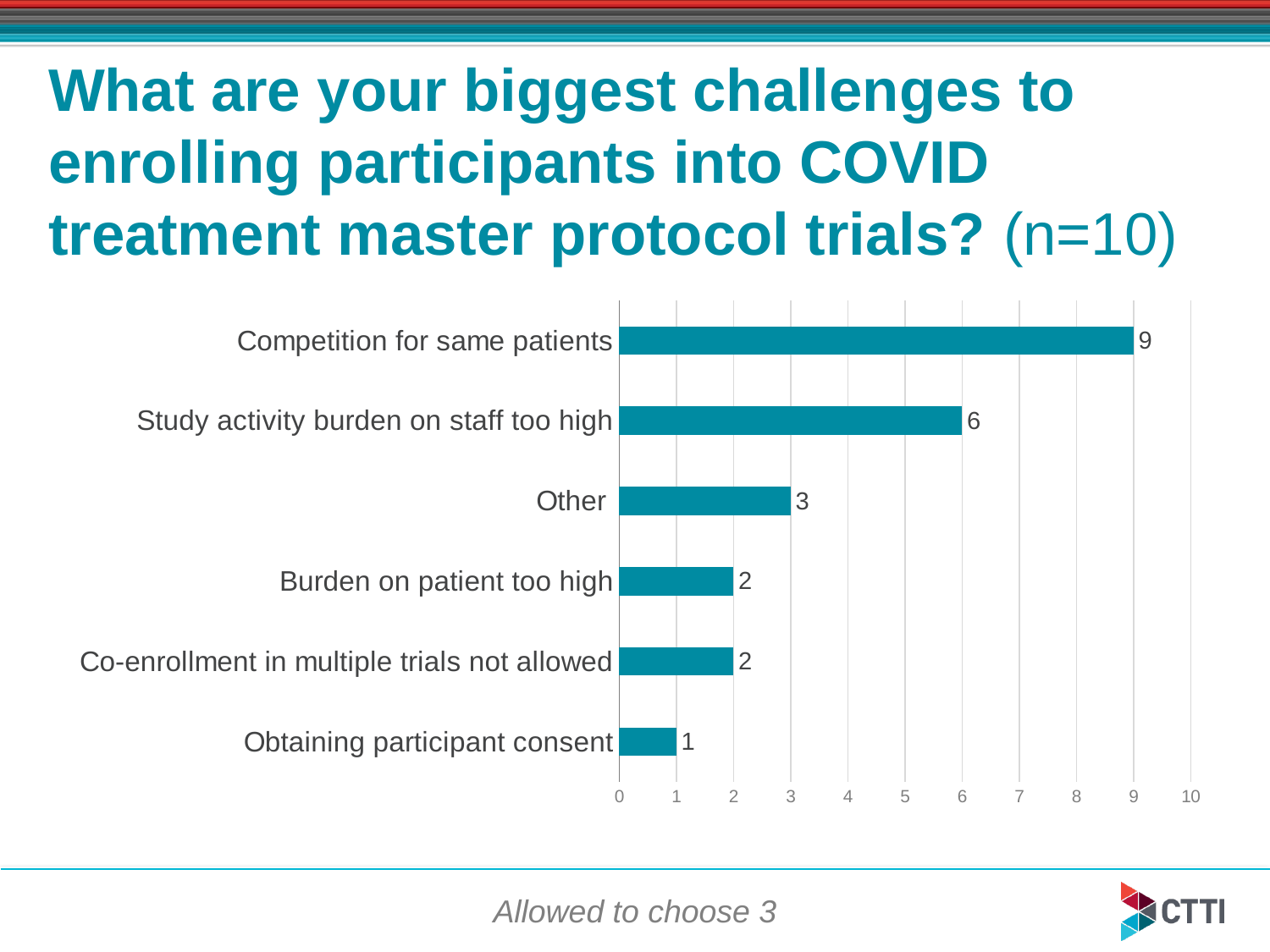
Which category has the lowest value? Obtaining participant consent What is the value for "Study activity burden on staff too high"? 6 What is the maximum value shown on the horizontal axis? 10 Which category has the highest value? Competition for same patients What is the value for "Other"? 3 How many categories are shown in the chart? 6 Which is larger: the value for "Other" or the value for "Burden on patient too high"? Other What is the difference between the values for "Competition for same patients" and "Study activity burden on staff too high"? 3 Is the value for "Study activity burden on staff too high" greater or less than 5? greater What kind of chart is shown on the slide? Bar chart What is the value for "Competition for same patients"? 9 What is the value for "Obtaining participant consent"? 1